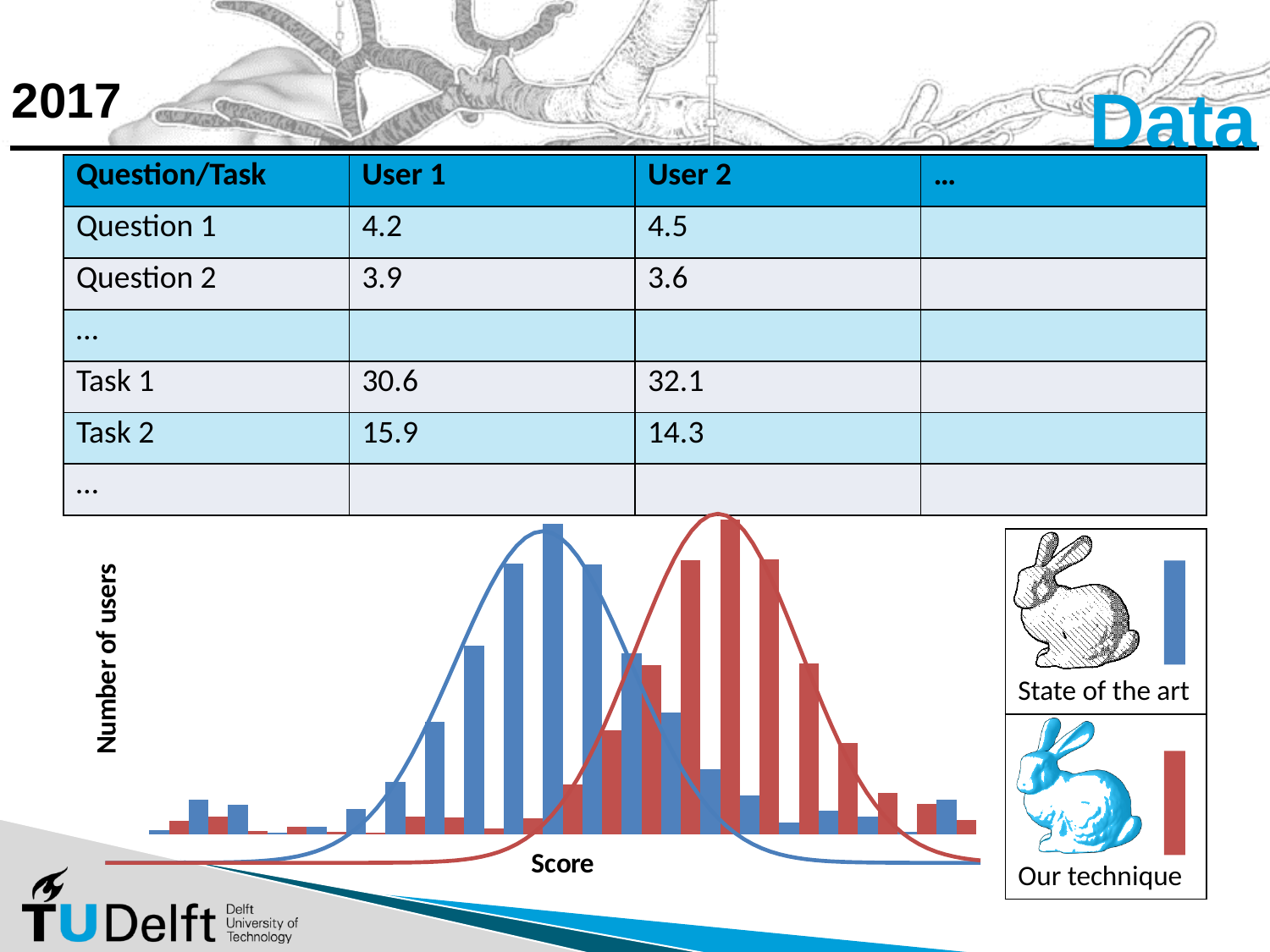
Which series in the chart has its peak at a higher score, State of the art or Our technique? Our technique How many series does the legend of the chart list? 2 Which series in the chart is centred at lower scores, State of the art or Our technique? State of the art What is the label of the x axis of the chart? Score What kind of chart is shown at the bottom of the slide? bar chart What is the label of the y axis of the chart? Number of users